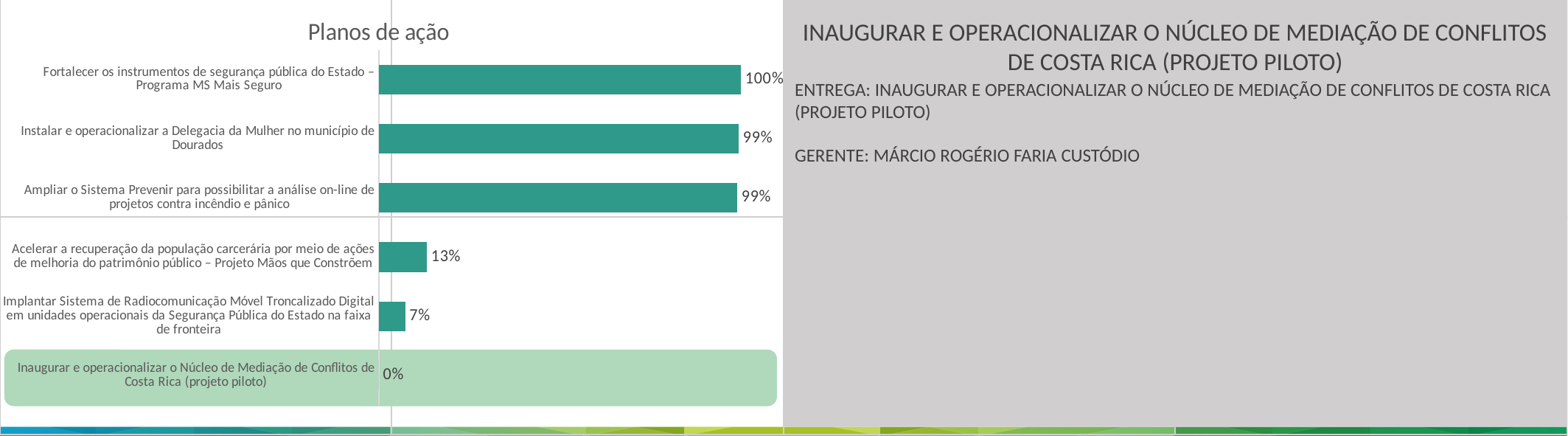
What is the value for "Instalar e operacionalizar a Delegacia da Mulher no município de Dourados"? 99% What is the value for "Inaugurar e operacionalizar o Núcleo de Mediação de Conflitos de Costa Rica (projeto piloto)"? 0% What is the value for "Fortalecer os instrumentos de segurança pública do Estado – Programa MS Mais Seguro"? 100% What is the value for "Implantar Sistema de Radiocomunicação Móvel Troncalizado Digital em unidades operacionais da Segurança Pública do Estado na faixa de fronteira"? 7% What kind of chart is shown on the slide? Bar chart Which category has the lowest value? Inaugurar e operacionalizar o Núcleo de Mediação de Conflitos de Costa Rica (projeto piloto) What is the difference between the value for "Acelerar a recuperação da população carcerária por meio de ações de melhoria do patrimônio público – Projeto Mãos que Constrõem" and the value for "Implantar Sistema de Radiocomunicação Móvel Troncalizado Digital em unidades operacionais da Segurança Pública do Estado na faixa de fronteira"? 6% Which is larger: the value for "Ampliar o Sistema Prevenir para possibilitar a análise on-line de projetos contra incêndio e pânico" or the value for "Acelerar a recuperação da população carcerária por meio de ações de melhoria do patrimônio público – Projeto Mãos que Constrõem"? Ampliar o Sistema Prevenir para possibilitar a análise on-line de projetos contra incêndio e pânico How many categories does the chart show? 6 Which category has the highest value? Fortalecer os instrumentos de segurança pública do Estado – Programa MS Mais Seguro What is the title of the chart? Planos de ação What is the value for "Acelerar a recuperação da população carcerária por meio de ações de melhoria do patrimônio público – Projeto Mãos que Constrõem"? 13%